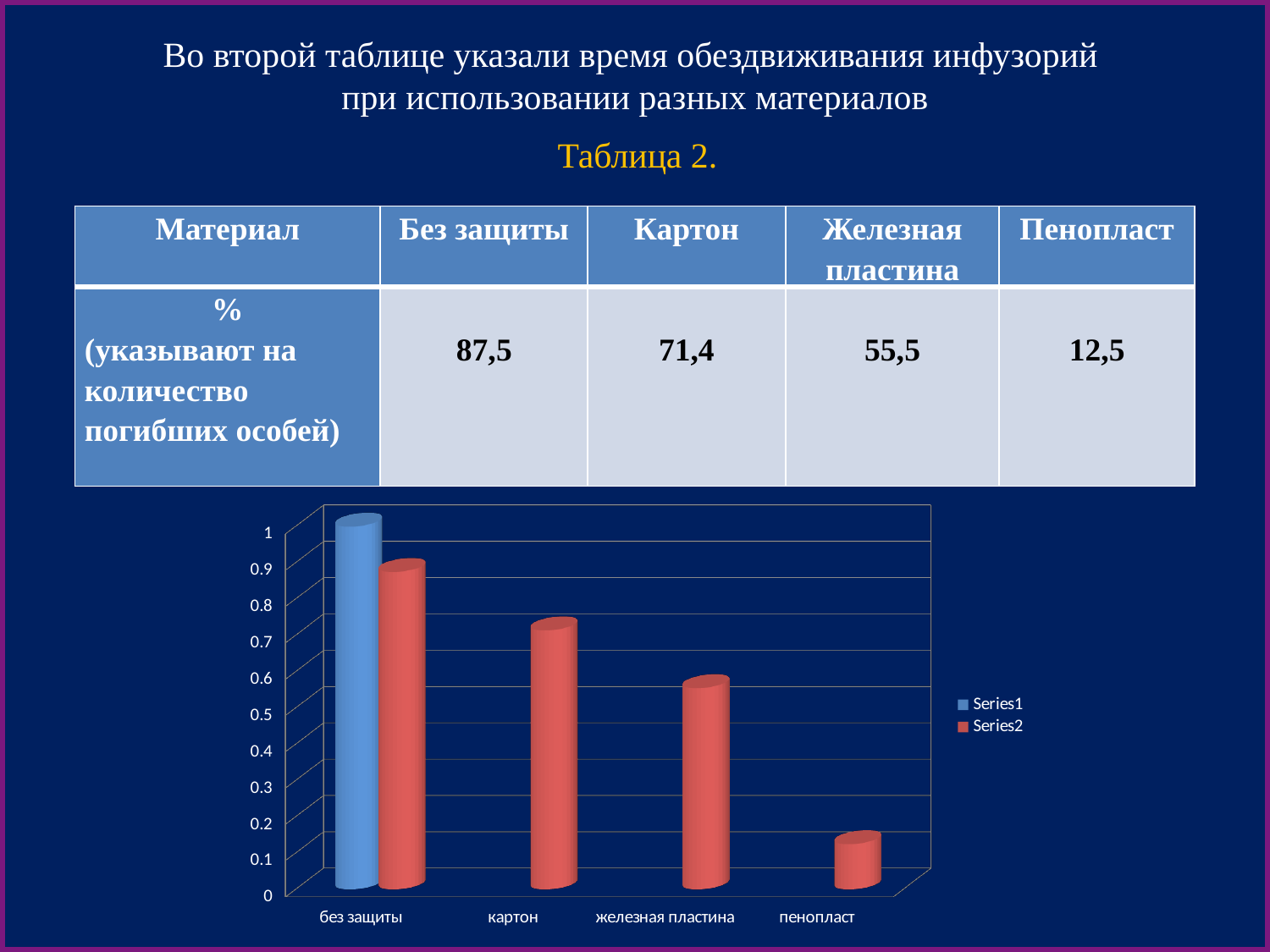
Is the Series2 value for без защиты greater or less than 0.8? greater Is the Series2 value for железная пластина greater or less than 0.4? greater What colour are the Series2 bars in the chart? red How many categories are shown on the x axis of the chart? 4 Is the Series2 value for пенопласт greater or less than 0.2? less Which category has the highest Series2 bar in the chart? без защиты What kind of chart is shown on the slide? bar chart Which has the larger Series2 value, картон or железная пластина? картон Which category has the lowest Series2 bar in the chart? пенопласт How many series does the chart legend list? 2 Do the Series2 values rise or fall from left to right along the x axis? fall